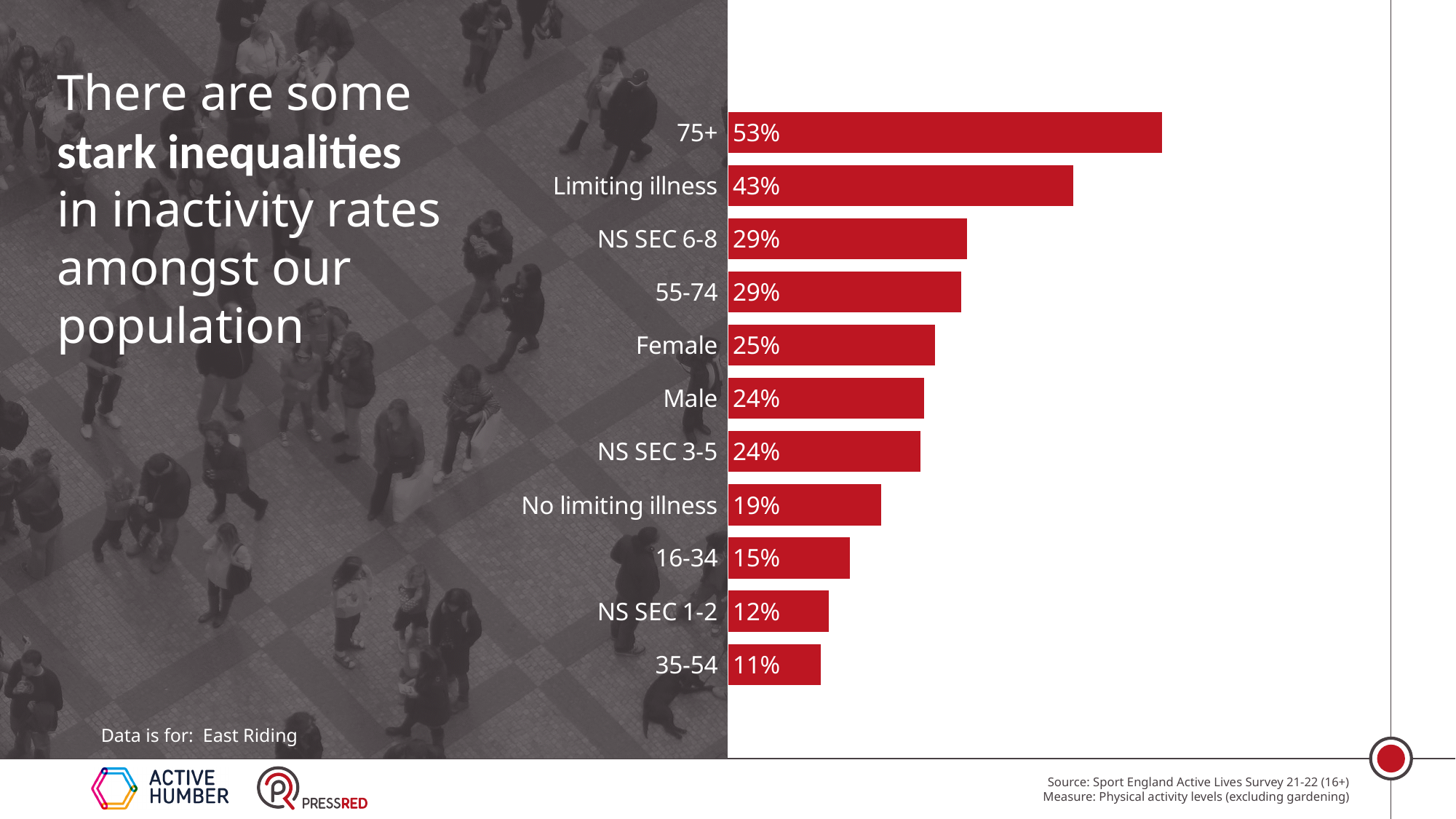
What is the difference in inactivity rate between the 75+ group and the 16-34 group? 38% What is the inactivity rate for the 75+ group? 53% What type of chart is shown on the slide? Bar chart What is the inactivity rate for people with a limiting illness? 43% Which area is the data on the slide for? East Riding Which has a higher inactivity rate, Female or Male? Female How many categories are shown in the chart? 11 What is the inactivity rate for the 35-54 age group? 11% Which category has the highest inactivity rate? 75+ Which category has the lowest inactivity rate? 35-54 What is the inactivity rate for NS SEC 1-2? 12% What is the difference in inactivity rate between people with a limiting illness and those with no limiting illness? 24%